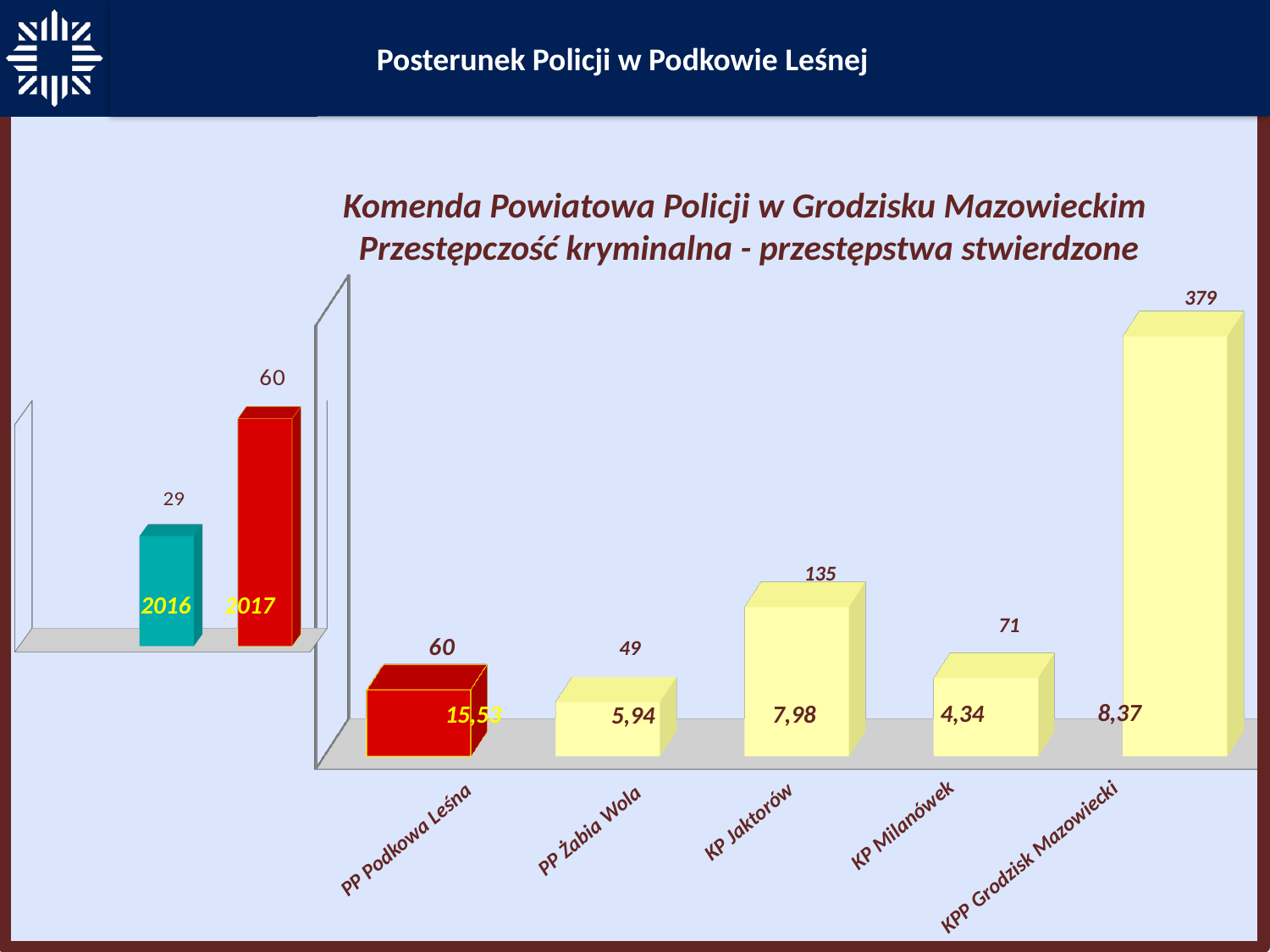
In the small chart on the left of the slide, what is the difference between the 2017 and 2016 values? 31 In the large chart titled 'Komenda Powiatowa Policji w Grodzisku Mazowieckim', what is the value for PP Żabia Wola? 49 In the large chart titled 'Komenda Powiatowa Policji w Grodzisku Mazowieckim', what is the value for KP Jaktorów? 135 In the large chart titled 'Komenda Powiatowa Policji w Grodzisku Mazowieckim', what is the difference between the values for KP Jaktorów and KP Milanówek? 64 What kind of chart is the large chart titled 'Komenda Powiatowa Policji w Grodzisku Mazowieckim'? Bar chart In the large chart titled 'Komenda Powiatowa Policji w Grodzisku Mazowieckim', which is larger: the value for PP Podkowa Leśna or PP Żabia Wola? PP Podkowa Leśna In the large chart titled 'Komenda Powiatowa Policji w Grodzisku Mazowieckim', which category has the lowest value? PP Żabia Wola In the large chart titled 'Komenda Powiatowa Policji w Grodzisku Mazowieckim', which category has the highest value? KPP Grodzisk Mazowiecki In the large chart titled 'Komenda Powiatowa Policji w Grodzisku Mazowieckim', what is the value for KPP Grodzisk Mazowiecki? 379 In the small chart on the left of the slide, what is the value for 2016? 29 In the small chart on the left of the slide, what is the value for 2017? 60 In the large chart titled 'Komenda Powiatowa Policji w Grodzisku Mazowieckim', how many categories are shown? 5